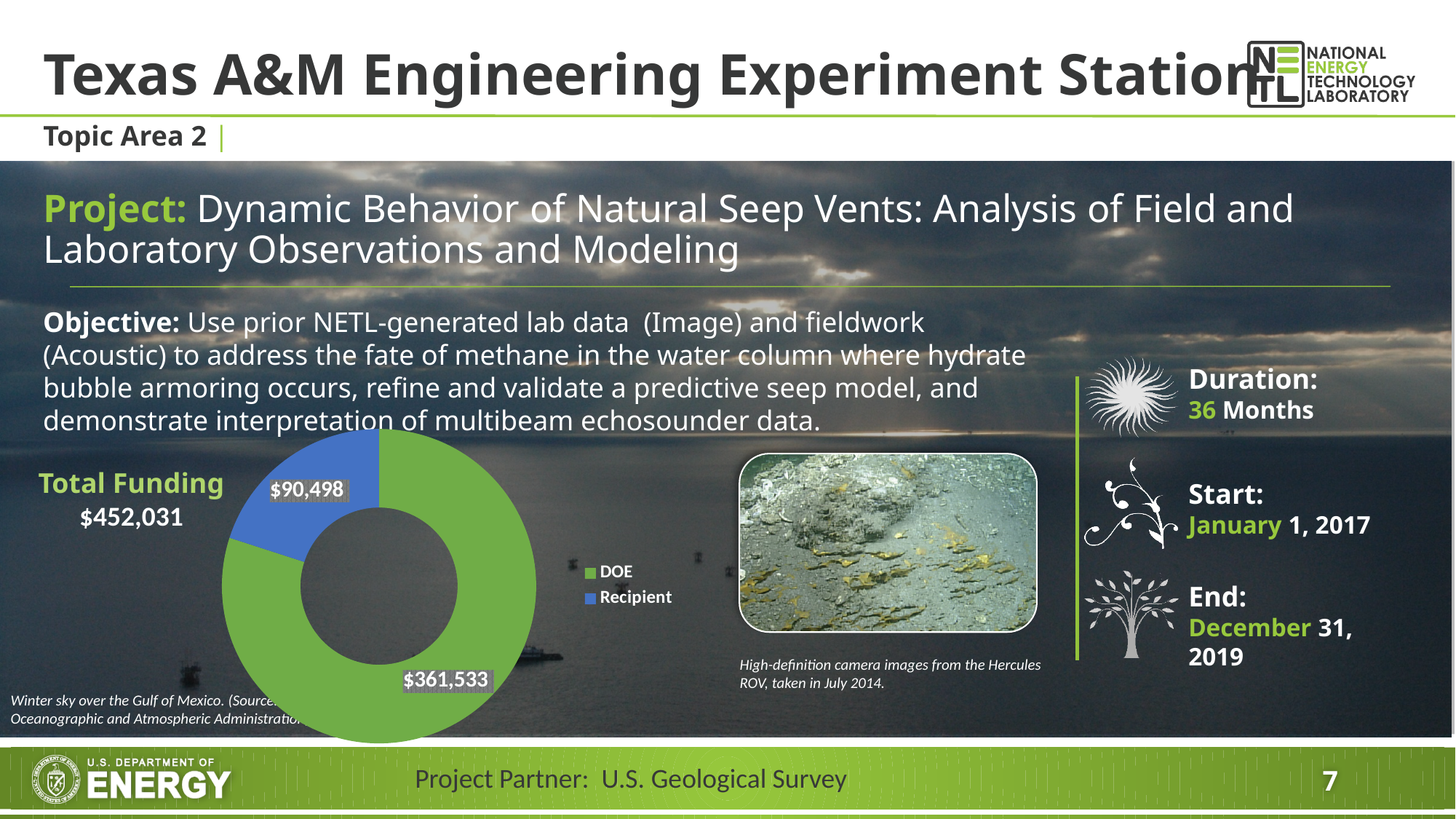
What colour represents the Recipient slice in the chart? Blue What is the DOE funding amount shown on the chart? $361,533 What type of chart is used to show the funding breakdown? Pie chart (donut) Is the DOE amount larger or smaller than the Recipient amount? Larger Which funding source has the smaller share of the chart? Recipient What is the difference between the DOE and Recipient funding amounts? $271,035 Which funding source has the larger share of the chart? DOE How many slices does the funding chart have? 2 What is the total funding shown next to the chart? $452,031 What is the Recipient funding amount shown on the chart? $90,498 How many series does the chart legend list? 2